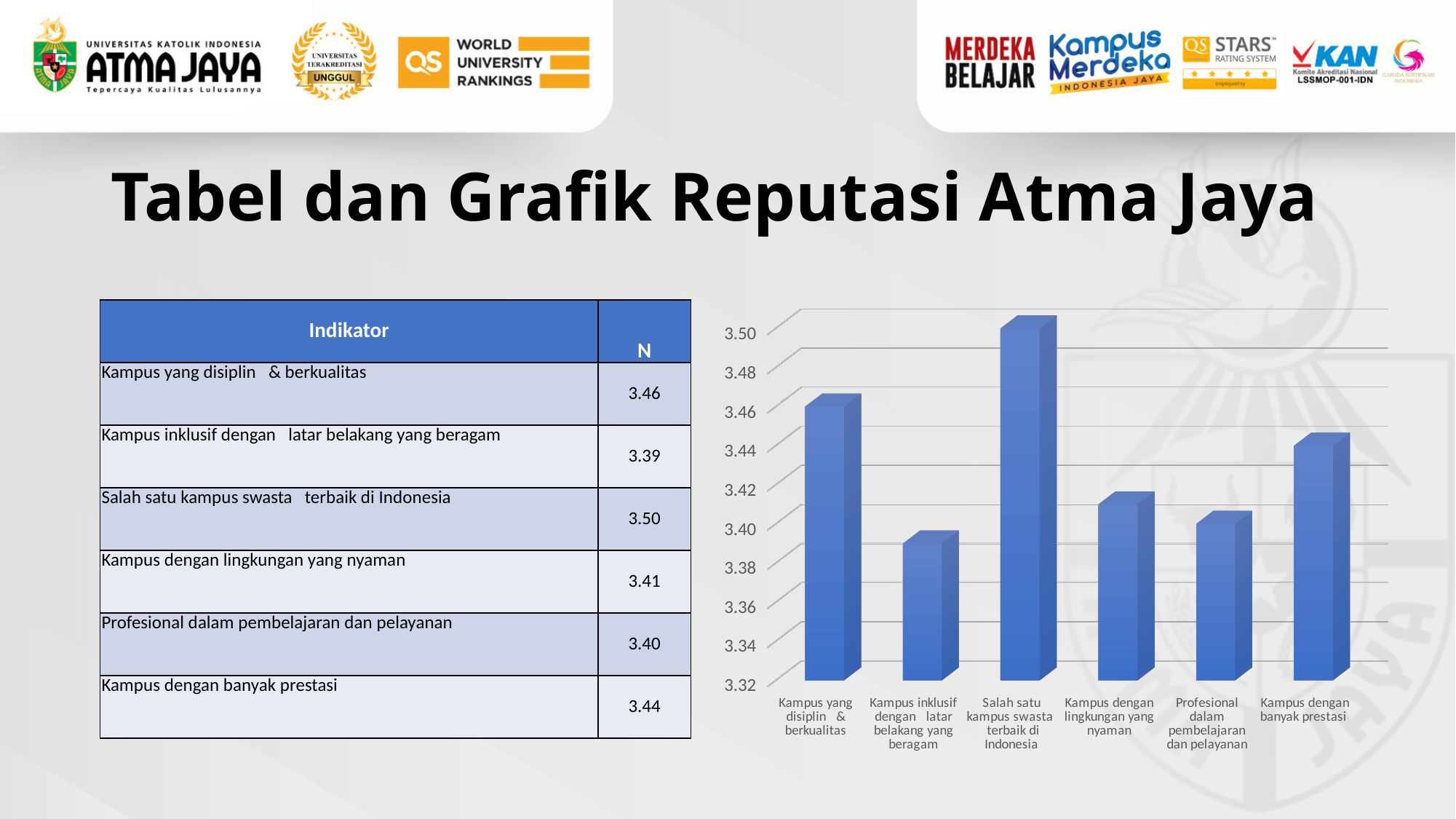
What type of chart is shown on the slide? Bar chart What is the lowest value shown on the chart's vertical axis? 3.32 Which indicator has the highest value in the chart? Salah satu kampus swasta terbaik di Indonesia What is the value for 'Kampus dengan banyak prestasi'? 3.44 What is the value for 'Kampus yang disiplin & berkualitas'? 3.46 Which indicator has the lowest value in the chart? Kampus inklusif dengan latar belakang yang beragam What is the title of the slide containing the chart? Tabel dan Grafik Reputasi Atma Jaya Is the value for 'Profesional dalam pembelajaran dan pelayanan' greater or less than 3.42? less What is the difference between the values for 'Salah satu kampus swasta terbaik di Indonesia' and 'Kampus inklusif dengan latar belakang yang beragam'? 0.11 Which is larger: the value for 'Kampus yang disiplin & berkualitas' or 'Kampus dengan banyak prestasi'? Kampus yang disiplin & berkualitas How many categories (indicators) are plotted in the bar chart? 6 What is the value for 'Kampus dengan lingkungan yang nyaman'? 3.41